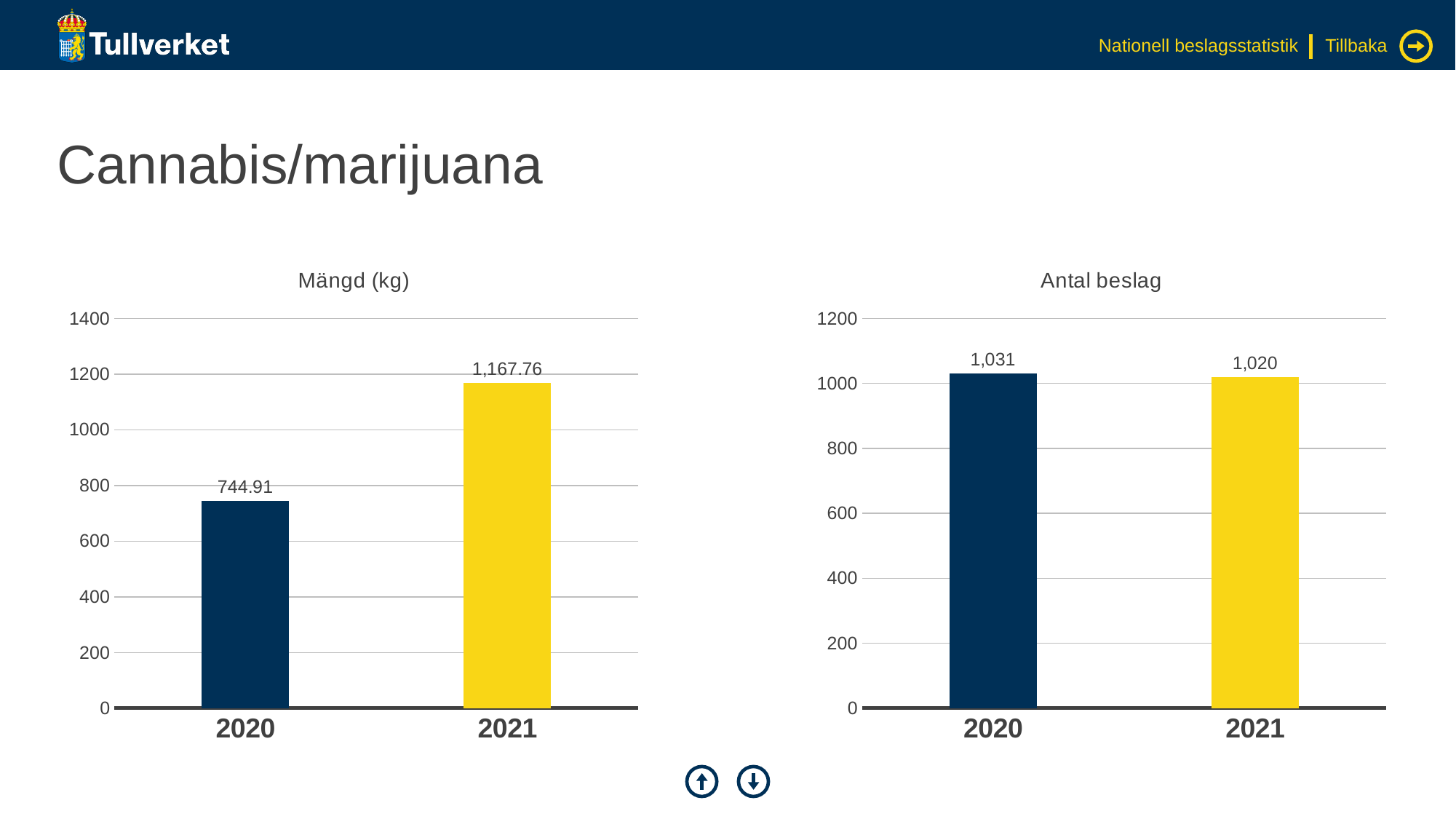
In the Mängd (kg) chart, what is the value for 2020? 744.91 In the Mängd (kg) chart, what is the value for 2021? 1,167.76 In the Mängd (kg) chart, is the value for 2020 greater or less than 800? less How many bars does the Antal beslag chart show? 2 In the Antal beslag chart, what is the value for 2021? 1,020 What kind of chart is the Mängd (kg) chart? bar chart In the Antal beslag chart, is the value for 2020 larger or smaller than the value for 2021? larger In the Mängd (kg) chart, which year has the highest value? 2021 In the Antal beslag chart, what is the difference between the 2020 and 2021 values? 11 In the Antal beslag chart, what is the value for 2020? 1,031 In the Antal beslag chart, which year has the lowest value? 2021 In the Mängd (kg) chart, what is the difference between the 2021 and 2020 values? 422.85